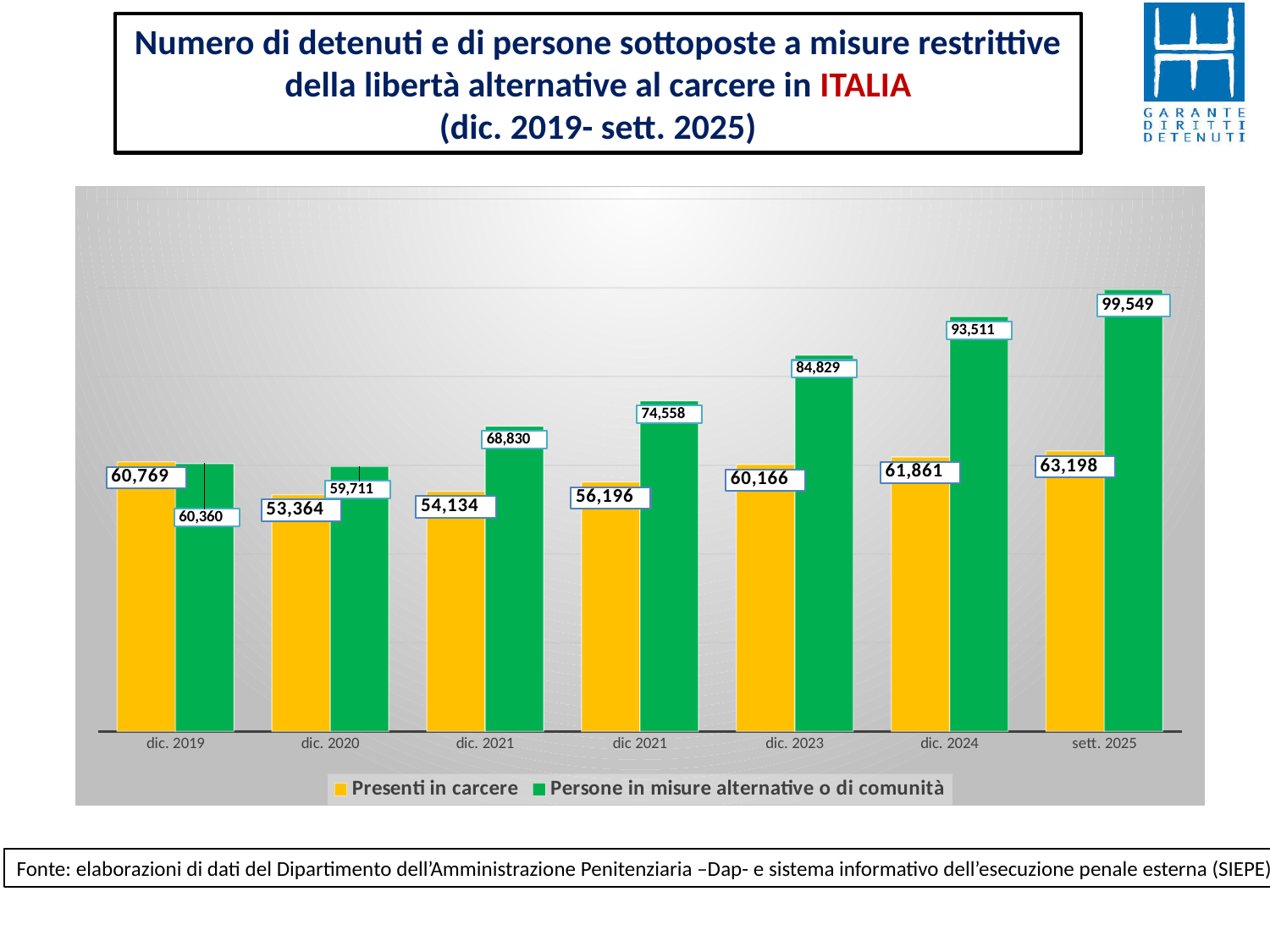
Do the values for 'Persone in misure alternative o di comunità' rise or fall from dic. 2020 to sett. 2025? Rise At sett. 2025, what is the difference between 'Persone in misure alternative o di comunità' and 'Presenti in carcere'? 36,351 At dic. 2019, which series has the larger value: 'Presenti in carcere' or 'Persone in misure alternative o di comunità'? Presenti in carcere What kind of chart is shown on the slide? Bar chart In which period is the value for 'Presenti in carcere' lowest? dic. 2020 What is the value for 'Presenti in carcere' at dic. 2024? 61,861 What is the value for 'Persone in misure alternative o di comunità' at sett. 2025? 99,549 What is the value for 'Presenti in carcere' at dic. 2020? 53,364 How many periods are shown on the x axis? 7 In which period is the value for 'Persone in misure alternative o di comunità' highest? sett. 2025 How many series does the legend list? 2 What is the value for 'Persone in misure alternative o di comunità' at dic. 2023? 84,829